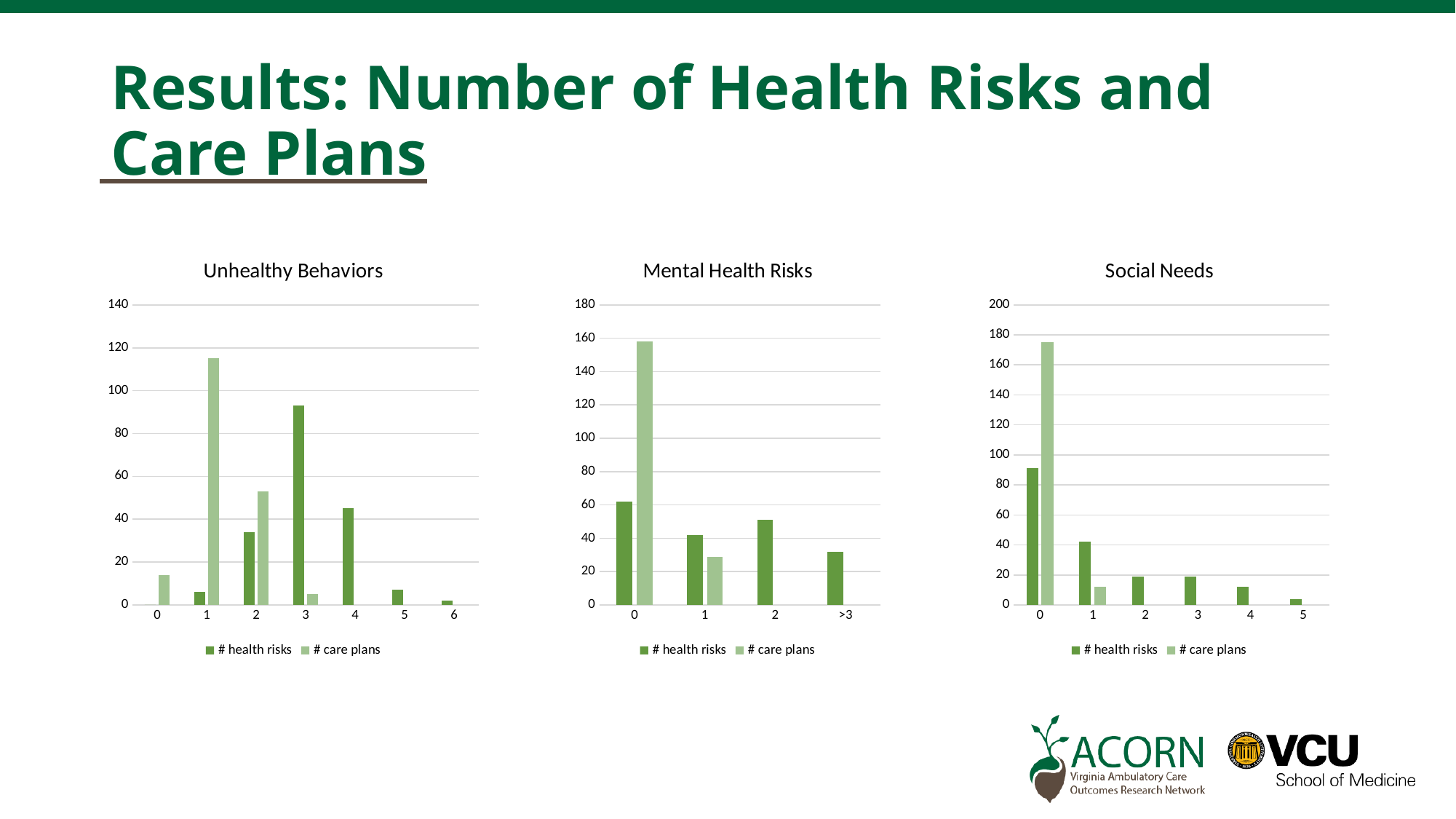
In the Mental Health Risks chart, which is larger for category 1: # health risks or # care plans? # health risks In the Mental Health Risks chart, which category has the highest # care plans bar? 0 In the Mental Health Risks chart, is the # care plans value for category 0 greater or less than 140? greater In the Unhealthy Behaviors chart, is the # health risks value for category 3 greater or less than 80? greater How many series does the legend of the Social Needs chart list? 2 How many categories are shown on the x axis of the Mental Health Risks chart? 4 In the Social Needs chart, which category has the lowest # health risks bar? 5 In the Social Needs chart, do the # health risks values generally rise or fall from category 0 to category 5? fall How many categories are shown on the x axis of the Unhealthy Behaviors chart? 7 In the Social Needs chart, is the # care plans value for category 0 greater or less than 160? greater In the Unhealthy Behaviors chart, which category has the highest # health risks bar? 3